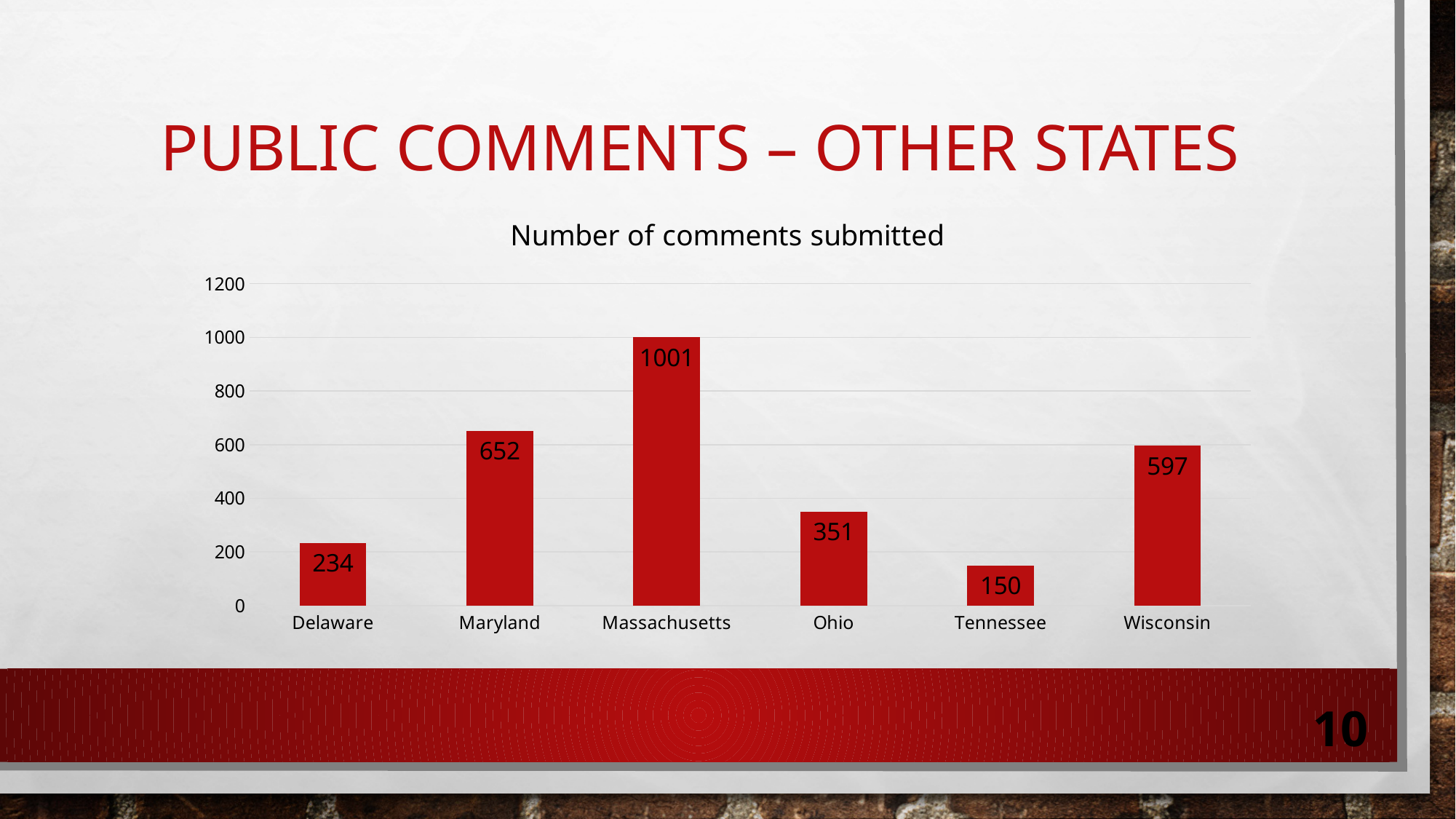
How many comments were submitted in Massachusetts? 1001 Which state has the lowest number of comments submitted? Tennessee What type of chart is shown on the slide? Bar chart What is the difference between the number of comments submitted in Maryland and Wisconsin? 55 What is the number of comments submitted for Ohio? 351 What is the title of the chart? Number of comments submitted Which state has the highest number of comments submitted? Massachusetts How many states are shown in the chart? 6 How many comments were submitted in Wisconsin? 597 Is the value for Maryland greater or less than 600? greater How many more comments were submitted in Massachusetts than in Delaware? 767 Which state had more comments submitted, Ohio or Delaware? Ohio